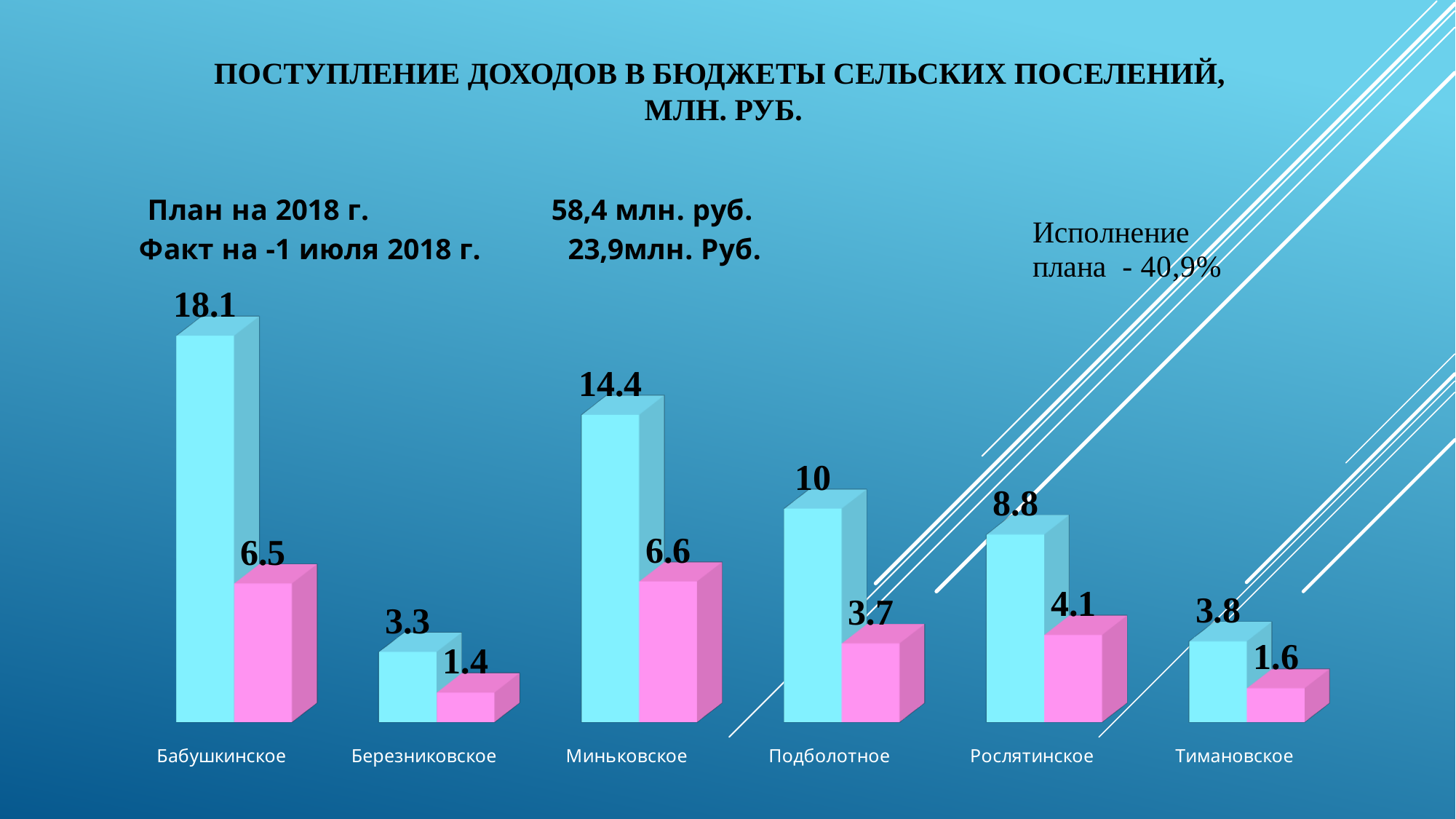
What is the value of the blue (first) bar for Подболотное? 10 What is the value of the pink (second) bar for Тимановское? 1.6 What is the difference between the blue and pink bars for Рослятинское? 4.7 What is the title of the chart on the slide? План на 2018 г. 58,4 млн. руб. Факт на -1 июля 2018 г. 23,9млн. Руб. How many categories (settlements) are shown on the x axis of the chart? 6 Which is larger: the blue bar for Миньковское or the blue bar for Подболотное? Миньковское What is the value of the pink (second) bar for Миньковское? 6.6 What type of chart is shown on the slide? bar chart Which category has the lowest pink (second) bar? Березниковское Which category has the highest blue (first) bar? Бабушкинское What is the value of the blue (first) bar for Бабушкинское? 18.1 What is the difference between the blue bars for Бабушкинское and Миньковское? 3.7